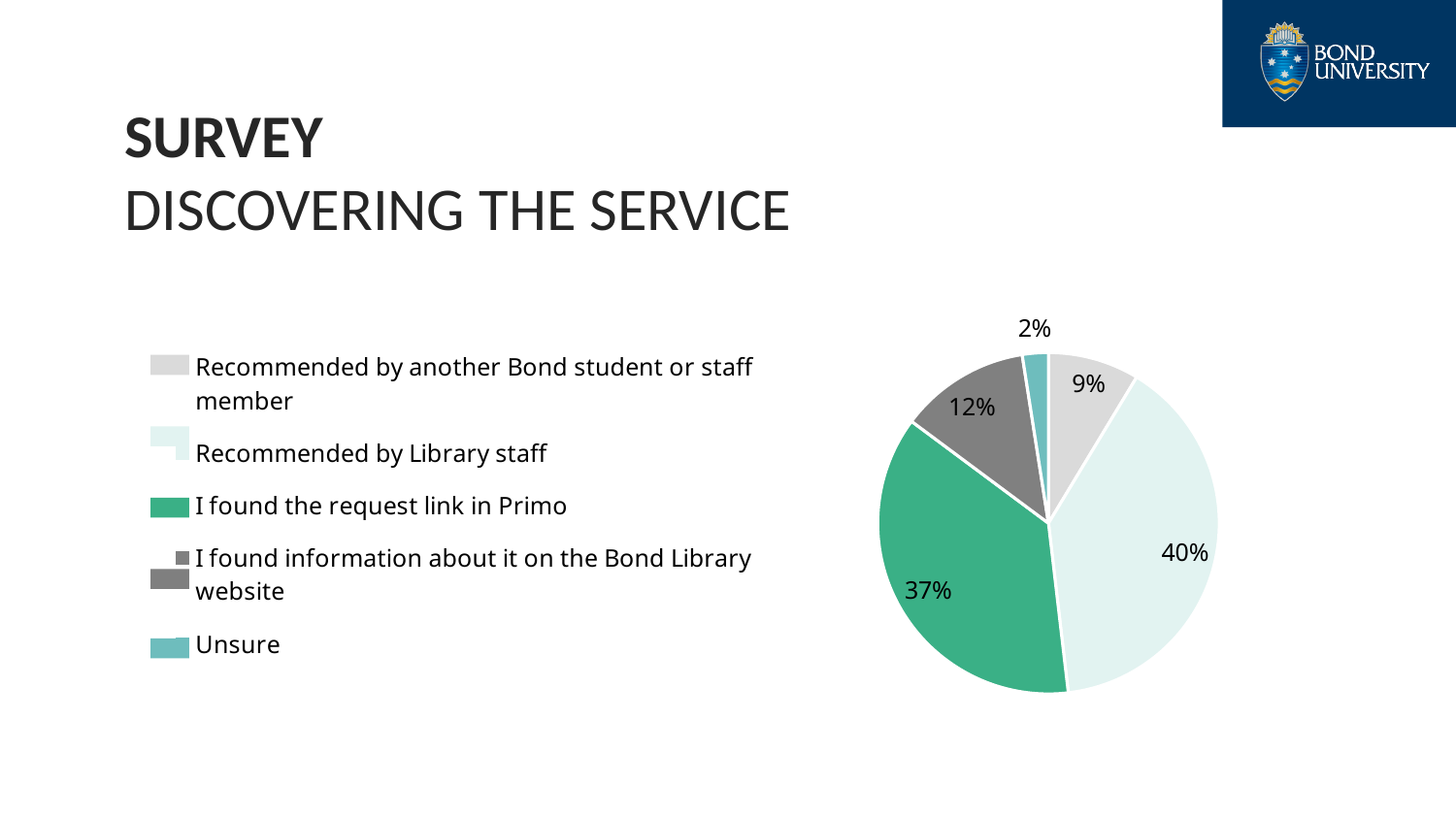
Which category has the smallest slice of the pie? Unsure What kind of chart is shown on the slide? pie chart What share of the pie is 'Recommended by Library staff'? 40% What share of the pie is 'Recommended by another Bond student or staff member'? 9% What is the difference in percentage points between 'Recommended by Library staff' and 'I found the request link in Primo'? 3 Which is larger: the slice for 'I found information about it on the Bond Library website' or the slice for 'Recommended by another Bond student or staff member'? I found information about it on the Bond Library website Which category has the largest slice of the pie? Recommended by Library staff What share of the pie is 'I found information about it on the Bond Library website'? 12% What colour is the slice for 'I found the request link in Primo'? green How many slices does the pie chart have? 5 What share of the pie is 'Unsure'? 2% What share of the pie is 'I found the request link in Primo'? 37%